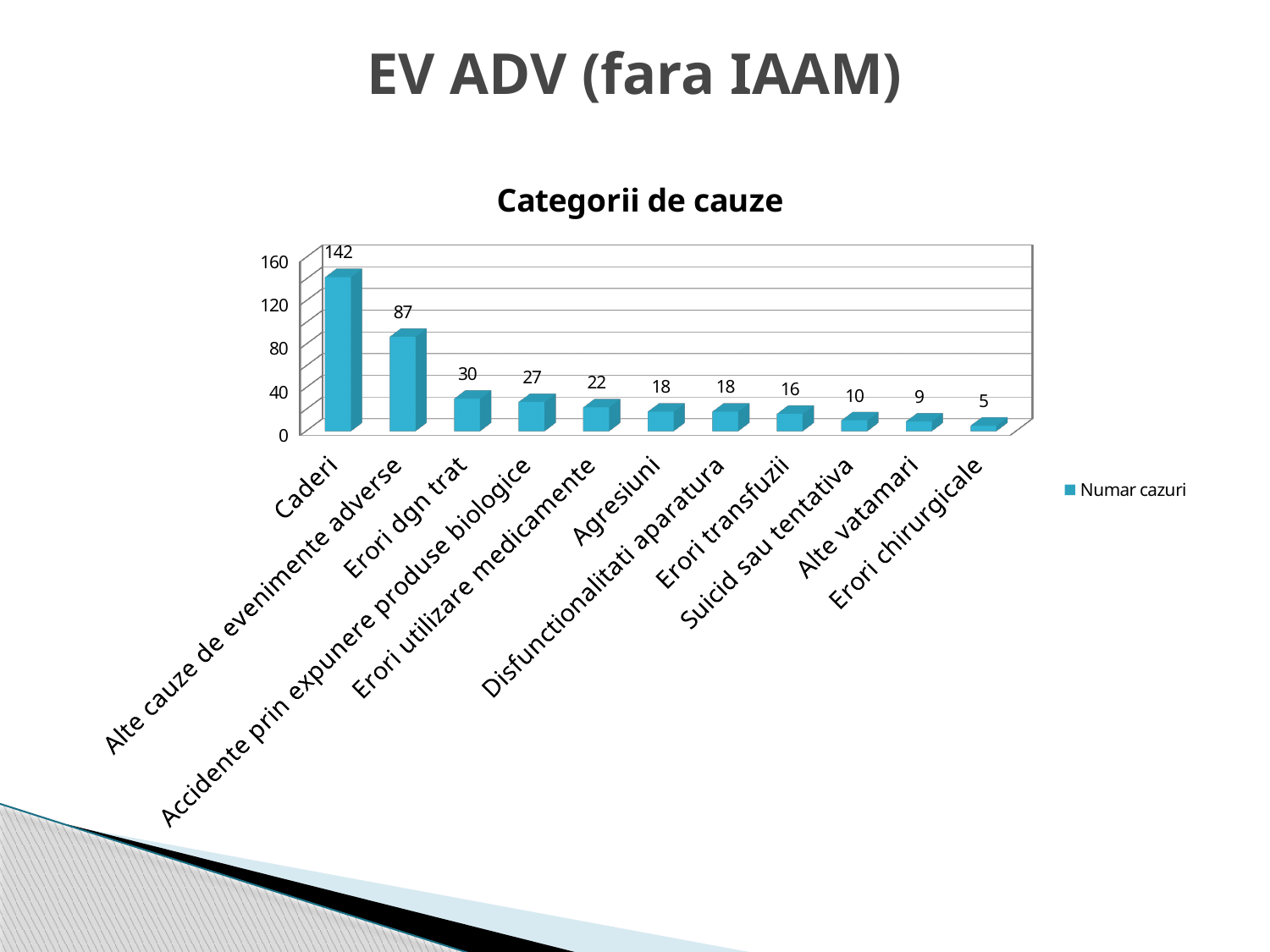
Which category has the highest value? Caderi What is the value for Caderi? 142 What kind of chart is shown? bar chart What is the difference between the values for Caderi and Alte cauze de evenimente adverse? 55 Which is larger, the value for Erori transfuzii or the value for Alte vatamari? Erori transfuzii What is the value for Suicid sau tentativa? 10 What is the title of the chart? Categorii de cauze Which category has the lowest value? Erori chirurgicale Is the value for Alte cauze de evenimente adverse greater or less than 80? greater How many categories are shown on the chart? 11 How many series does the legend list? 1 What is the value for Erori dgn trat? 30